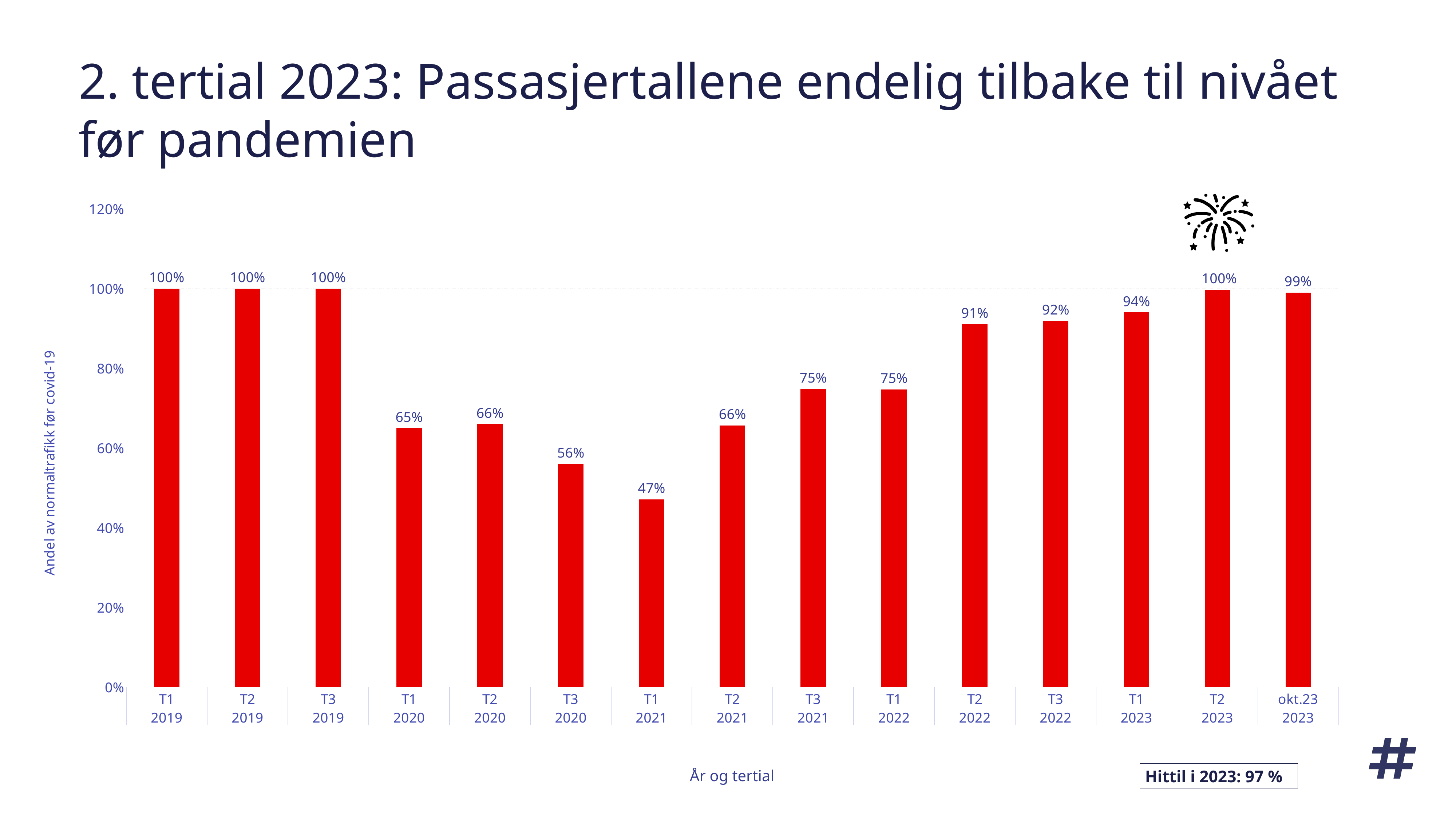
Which category has the lowest value? T1 2021 What is the value for T1 2021? 47% What is the difference between the values for T2 2023 and T1 2023? 6% Which is larger, the value for T1 2020 or the value for T3 2021? T3 2021 What is the label of the y axis? Andel av normaltrafikk før covid-19 Is the value for T3 2022 greater or less than 80%? greater What is the value for T2 2022? 91% What kind of chart is shown on the slide? Bar chart Do the values rise or fall from T1 2021 to T2 2023? Rise What is the value for okt.23 2023? 99% How many categories are shown on the x axis? 15 What is the difference between the values for T3 2020 and T1 2021? 9%